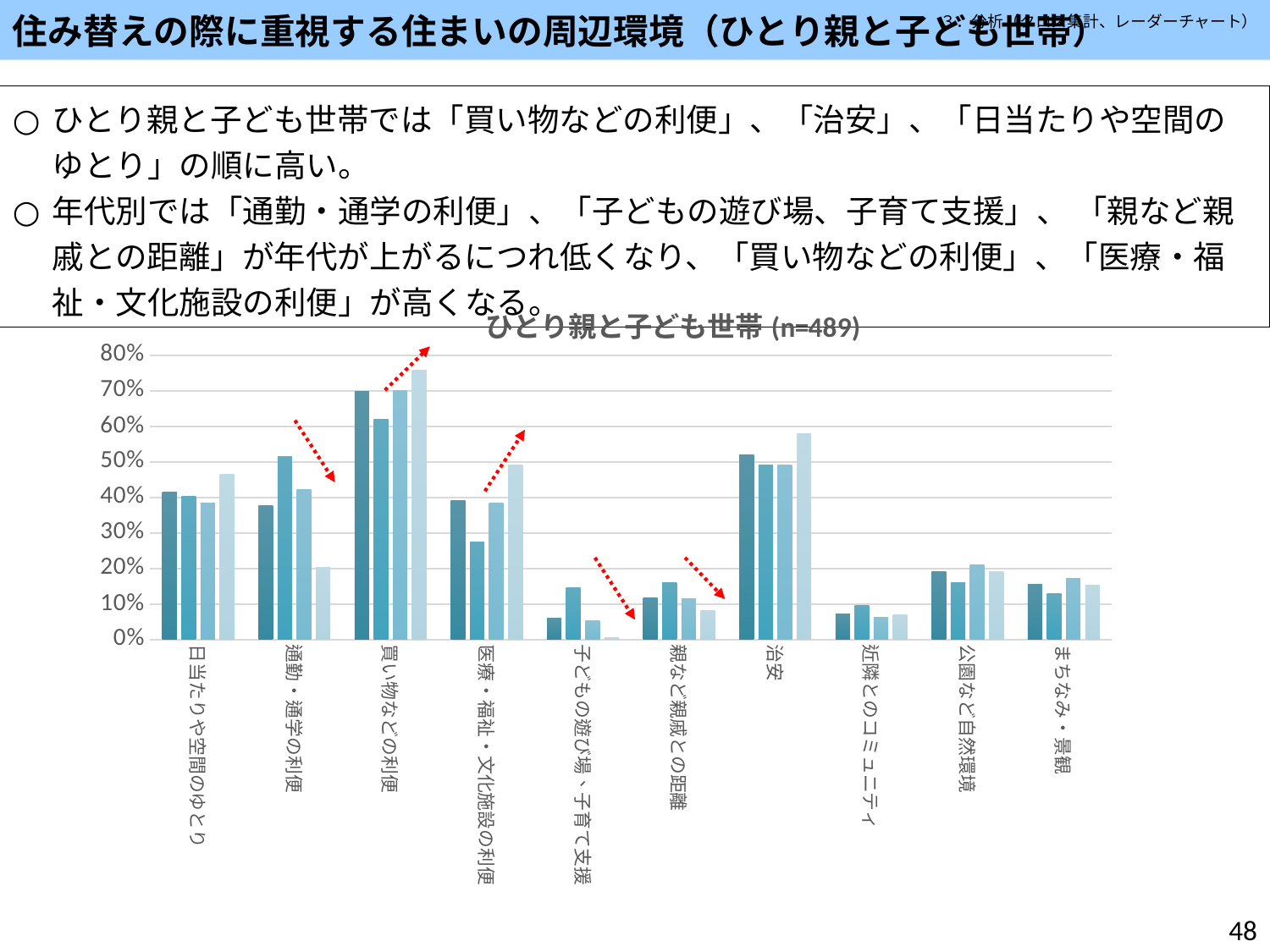
Is the value of the lightest (fourth) bar for 治安 greater or less than 50%? greater How many categories are shown on the x axis of the chart? 10 Is the value of the lightest (fourth) bar for 買い物などの利便 greater or less than 70%? greater Which category contains the shortest bar in the chart? 子どもの遊び場、子育て支援 Which category contains the tallest bar in the chart? 買い物などの利便 Which category has higher values overall, 買い物などの利便 or 日当たりや空間のゆとり? 買い物などの利便 Are the bars for 治安 taller or shorter than the bars for 公園など自然環境? taller Is the value of the darkest (first) bar for 子どもの遊び場、子育て支援 greater or less than 10%? less What kind of chart is shown on the slide? bar chart How many bars are plotted for each category in the chart? 4 What is the title of the chart? ひとり親と子ども世帯 (n=489)